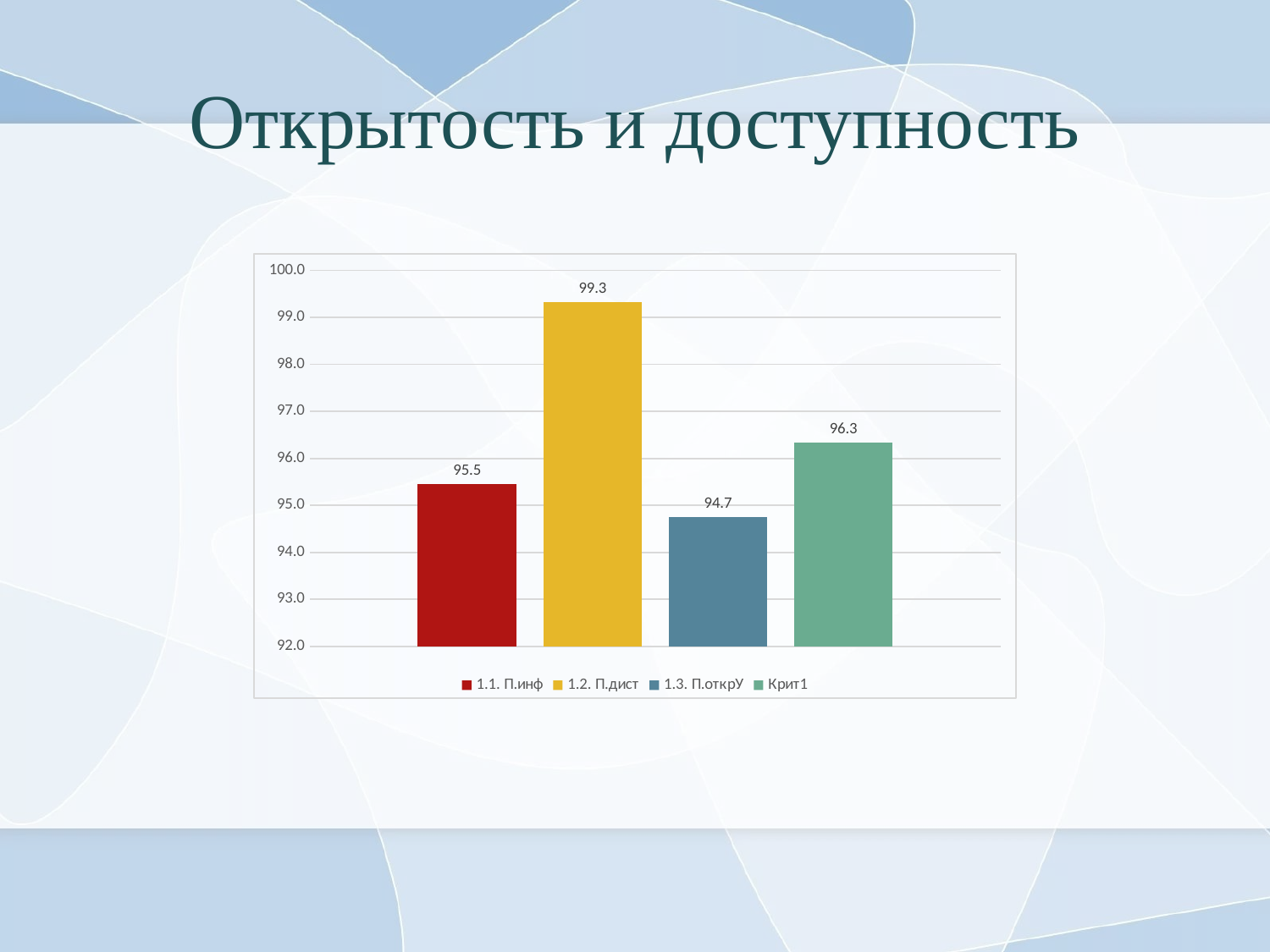
What is the value for Крит1? 96.3 Is the value for 1.2. П.дист greater or less than 98.0? greater What is the value for 1.3. П.открУ? 94.7 What is the value for 1.2. П.дист? 99.3 Which series has the lowest value? 1.3. П.открУ Which is larger, the value for Крит1 or the value for 1.1. П.инф? Крит1 How many series does the legend list? 4 What is the difference between the values for 1.2. П.дист and 1.3. П.открУ? 4.6 How many bars are plotted in the chart? 4 What kind of chart is shown on the slide? bar chart Which series has the highest value? 1.2. П.дист What is the value for 1.1. П.инф? 95.5